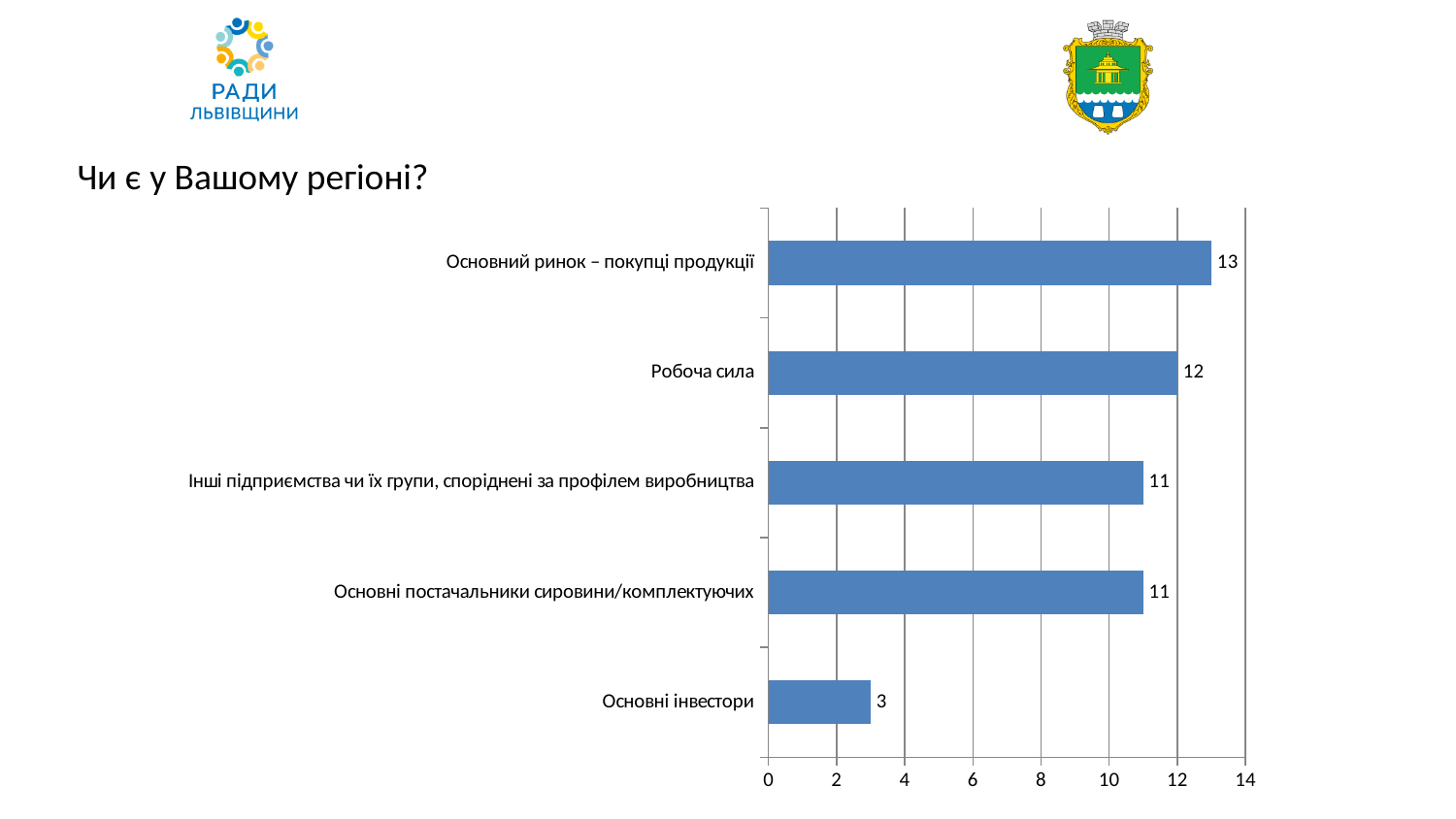
Which is larger: the value for "Робоча сила" or the value for "Основні інвестори"? Робоча сила What is the value for "Робоча сила"? 12 Which category has the lowest value? Основні інвестори What is the value for "Основний ринок – покупці продукції"? 13 What is the title of the slide above the chart? Чи є у Вашому регіоні? What is the value for "Основні постачальники сировини/комплектуючих"? 11 What is the maximum value shown on the horizontal axis? 14 What is the value for "Основні інвестори"? 3 What is the difference between the values for "Основний ринок – покупці продукції" and "Основні інвестори"? 10 Which category has the highest value? Основний ринок – покупці продукції How many categories are shown in the chart? 5 What kind of chart is shown on the slide? Bar chart